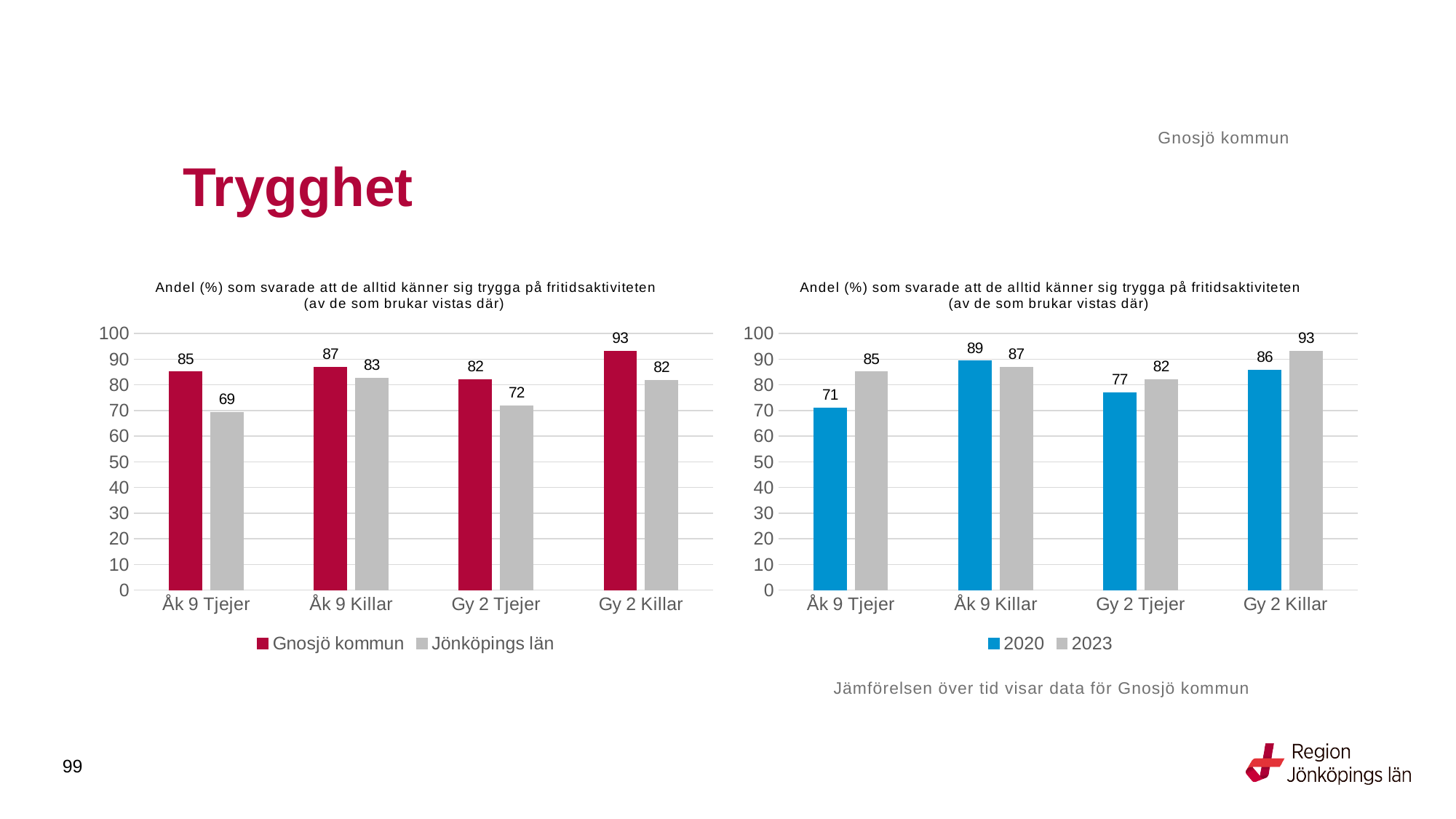
In the left chart, what is the difference between Gnosjö kommun and Jönköpings län for Åk 9 Tjejer? 16 What kind of chart is the right chart? Bar chart In the right chart, how many categories are shown on the x axis? 4 In the left chart, what is the value for Jönköpings län for Gy 2 Tjejer? 72 In the left chart, what is the value for Gnosjö kommun for Åk 9 Tjejer? 85 In the right chart, what is the difference between 2023 and 2020 for Åk 9 Tjejer? 14 In the right chart, what is the value for 2023 for Gy 2 Killar? 93 In the right chart, which is larger for Åk 9 Killar, 2020 or 2023? 2020 In the left chart, which category has the highest value for Gnosjö kommun? Gy 2 Killar In the right chart, what is the value for 2020 for Gy 2 Tjejer? 77 In the left chart, which category has the lowest value for Jönköpings län? Åk 9 Tjejer In the left chart, how many series does the legend list? 2